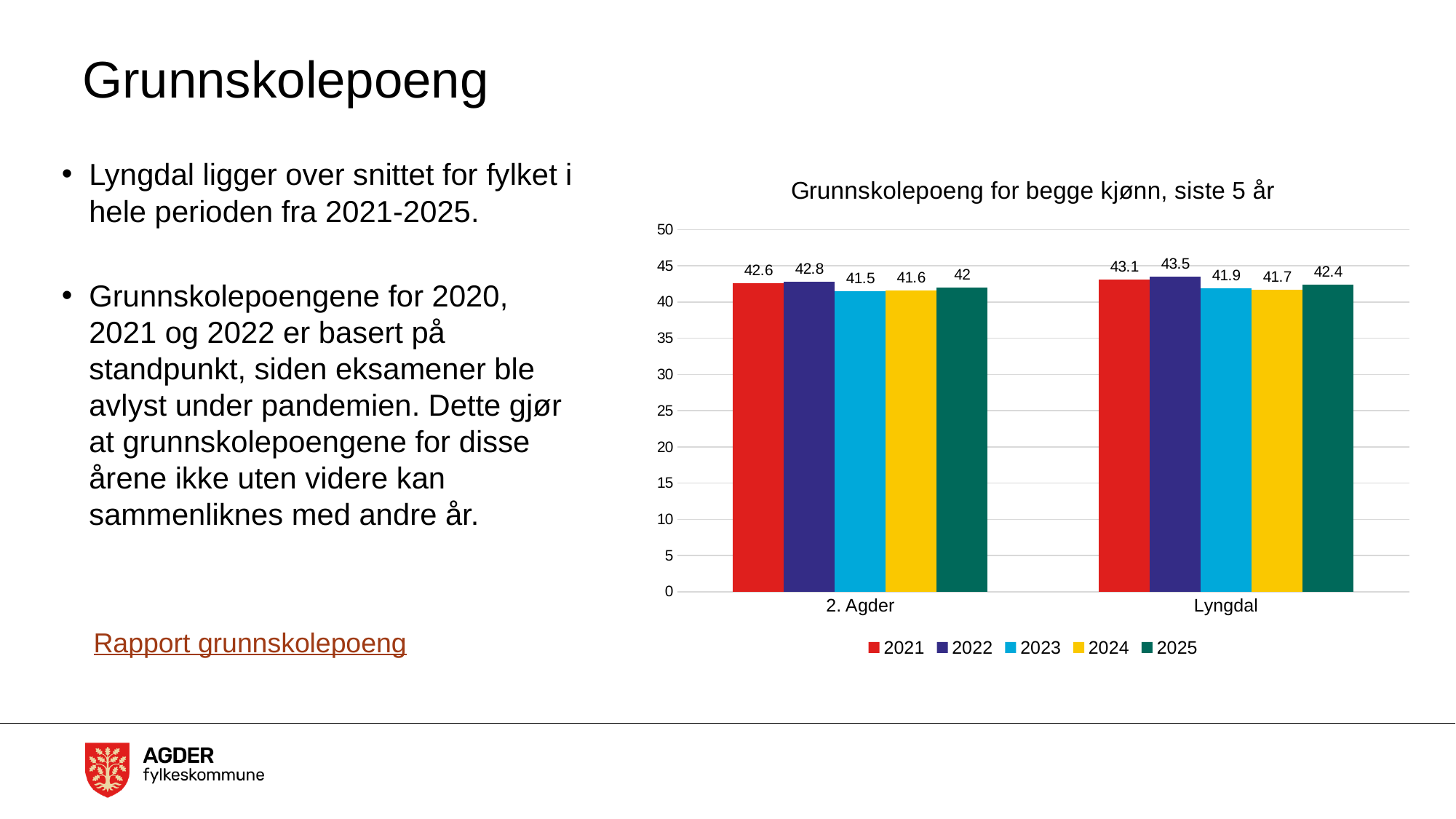
Which is larger, the 2023 value for Lyngdal or the 2023 value for 2. Agder? Lyngdal What is the difference between Lyngdal and 2. Agder in 2022? 0.7 What is the value for 2. Agder in 2024? 41.6 How many series does the legend list? 5 What is the value for Lyngdal in 2022? 43.5 Which year has the highest value for Lyngdal? 2022 What kind of chart is shown on the slide? Bar chart How many categories are shown on the x axis? 2 What is the title of the chart? Grunnskolepoeng for begge kjønn, siste 5 år What is the value for 2. Agder in 2021? 42.6 Which year has the lowest value for 2. Agder? 2023 What is the value for Lyngdal in 2025? 42.4